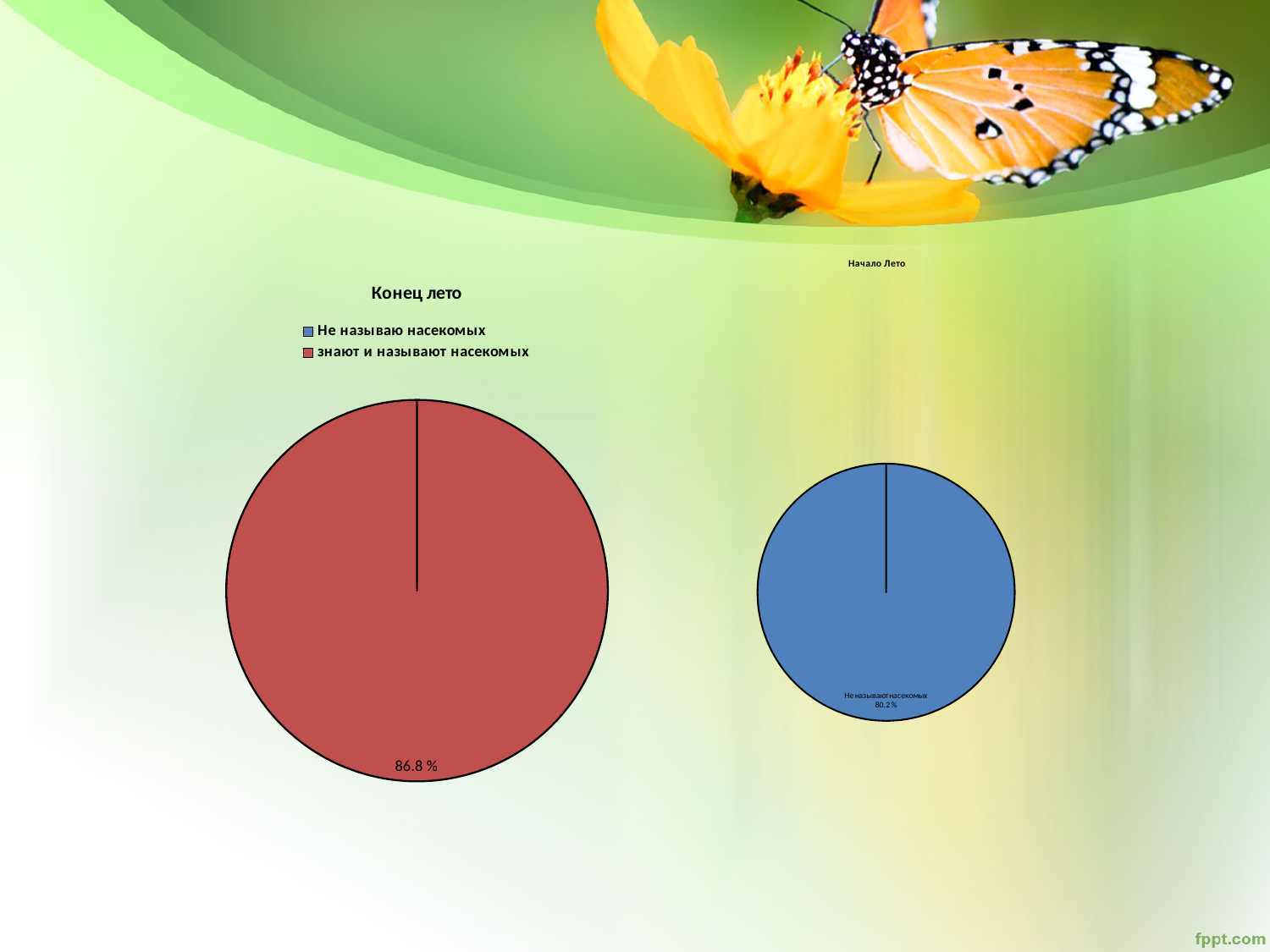
In the chart titled "Начало Лето", which category does the printed value 80.2 % belong to? Не называют насекомых Which chart shows the larger printed value, "Конец лето" or "Начало Лето"? Конец лето What is the difference between the value printed on the "Конец лето" chart (86.8 %) and the value printed on the "Начало Лето" chart (80.2 %)? 6.6 % In the chart titled "Конец лето", how many entries does the legend list? 2 What is the title of the chart on the right of the slide? Начало Лето What is the title of the chart on the left of the slide? Конец лето What kind of chart is the chart on the left of the slide? pie chart What kind of chart is the chart on the right of the slide? pie chart In the chart titled "Начало Лето", what value is printed on the pie? 80.2 % In the chart titled "Конец лето", what value is printed on the pie? 86.8 %